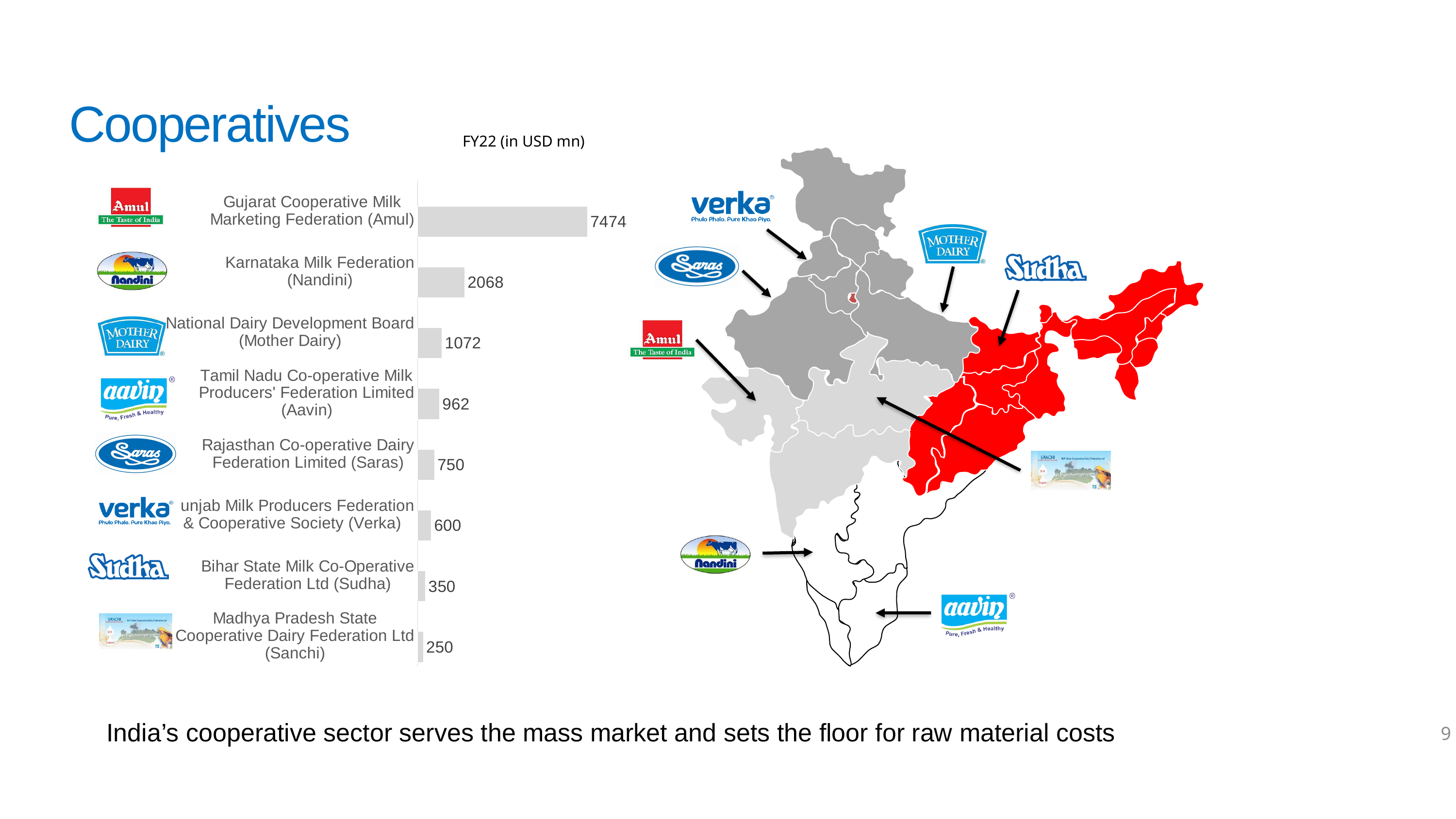
What is the FY22 value (in USD mn) for Rajasthan Co-operative Dairy Federation Limited (Saras)? 750 What is the FY22 value (in USD mn) for Gujarat Cooperative Milk Marketing Federation (Amul)? 7474 What is the difference between the FY22 values for Mother Dairy and Aavin (in USD mn)? 110 Which has a larger FY22 value, Verka or Sudha? Verka How many cooperatives are shown in the bar chart? 8 What is the FY22 value (in USD mn) for Karnataka Milk Federation (Nandini)? 2068 What is the difference between the FY22 values for Amul and Nandini (in USD mn)? 5406 What is the FY22 value (in USD mn) for Bihar State Milk Co-Operative Federation Ltd (Sudha)? 350 Which cooperative has the lowest FY22 value in the chart? Madhya Pradesh State Cooperative Dairy Federation Ltd (Sanchi) What kind of chart is used to show the FY22 values? Bar chart Which cooperative has the highest FY22 value in the chart? Gujarat Cooperative Milk Marketing Federation (Amul) What is the title of the chart? FY22 (in USD mn)